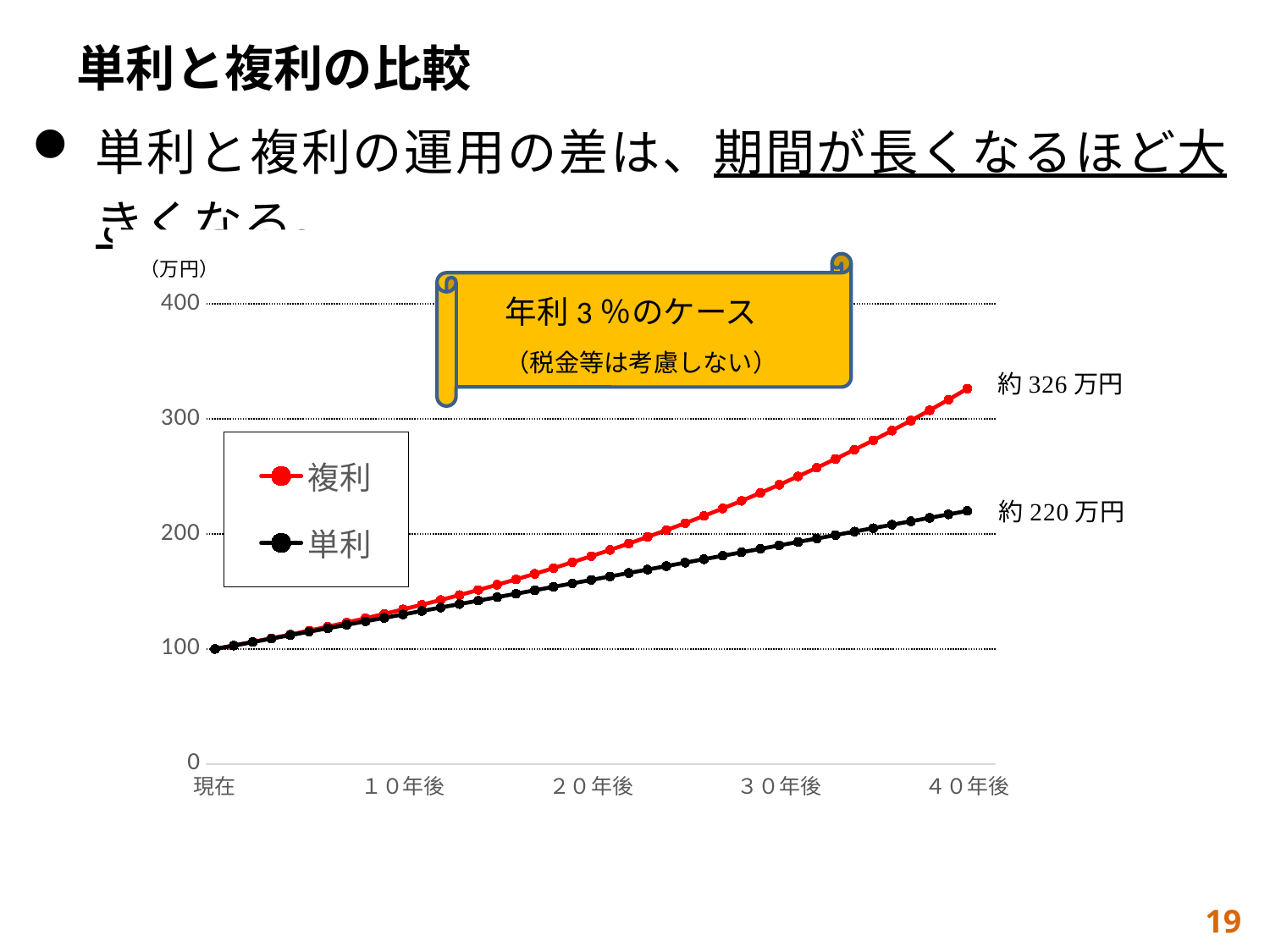
What value do both lines start at for 現在? 100 What is the labelled value of the 複利 line at 40年後? 約 326 万円 What kind of chart is shown on the slide? line chart Is the value of the 複利 line at 20年後 greater or less than 200? less What are the two series named in the legend? 複利 and 単利 How many series does the legend list? 2 What annual interest rate does the callout on the chart say is assumed? 年利3％ What is the labelled value of the 単利 line at 40年後? 約 220 万円 Do the values of the 複利 line rise or fall from 現在 to 40年後? rise Is the value of the 単利 line at 30年後 greater or less than 200? less Which series has the higher value at 40年後, 複利 or 単利? 複利 Is the value of the 複利 line at 30年後 greater or less than 200? greater